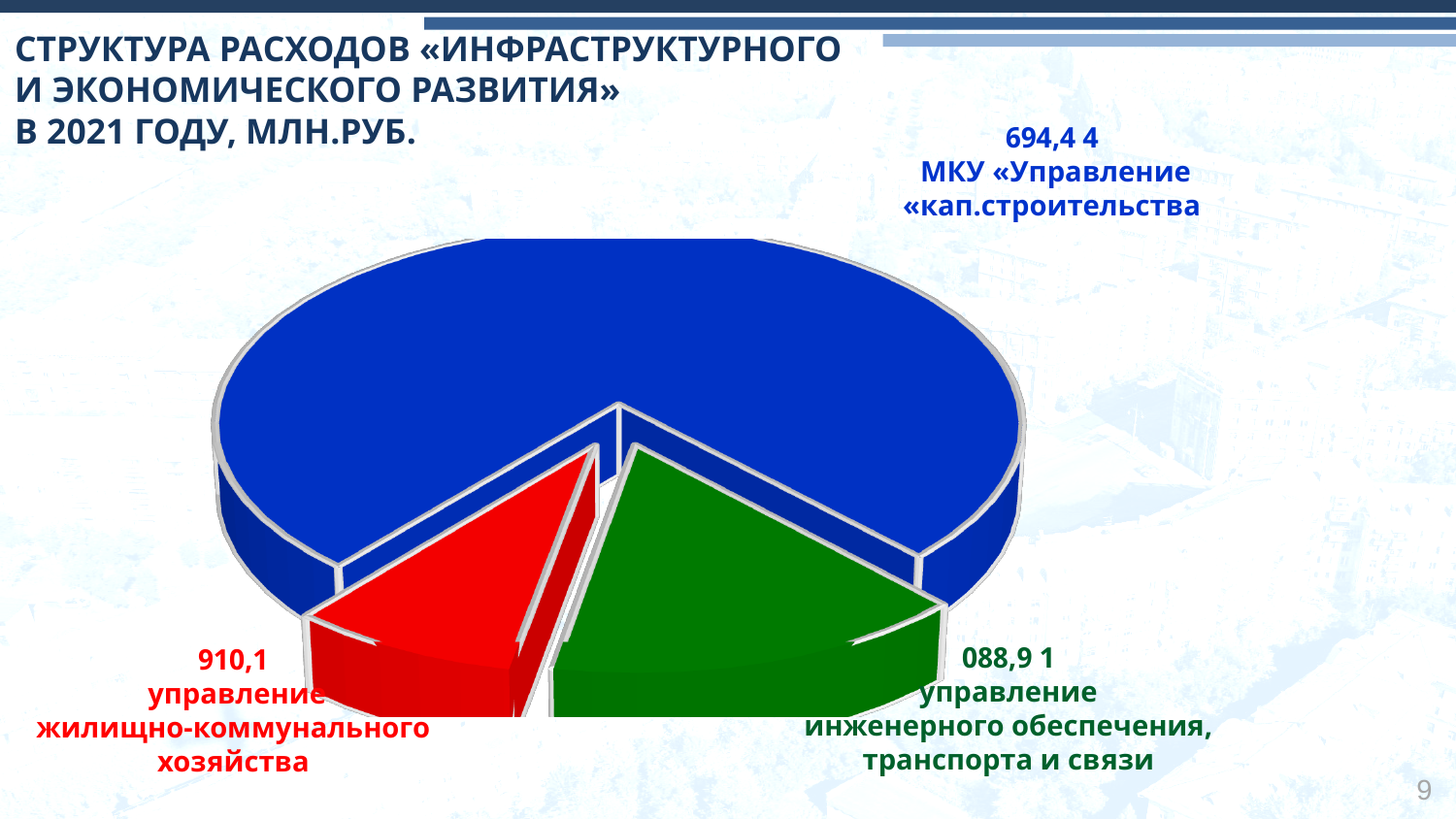
Which category has the smallest slice of the pie chart? управление жилищно-коммунального хозяйства What kind of chart is shown on the slide? pie chart Which category has the largest slice of the pie chart? МКУ «Управление кап.строительства» In what units are the values on the chart expressed, according to the slide title? млн.руб. Which slice is larger: МКУ «Управление кап.строительства» or управление инженерного обеспечения, транспорта и связи? МКУ «Управление кап.строительства» What colour is the slice for управление жилищно-коммунального хозяйства? red What is the value shown for управление жилищно-коммунального хозяйства? 910,1 How many slices does the pie chart have? 3 Which slice is larger: управление инженерного обеспечения, транспорта и связи or управление жилищно-коммунального хозяйства? управление инженерного обеспечения, транспорта и связи